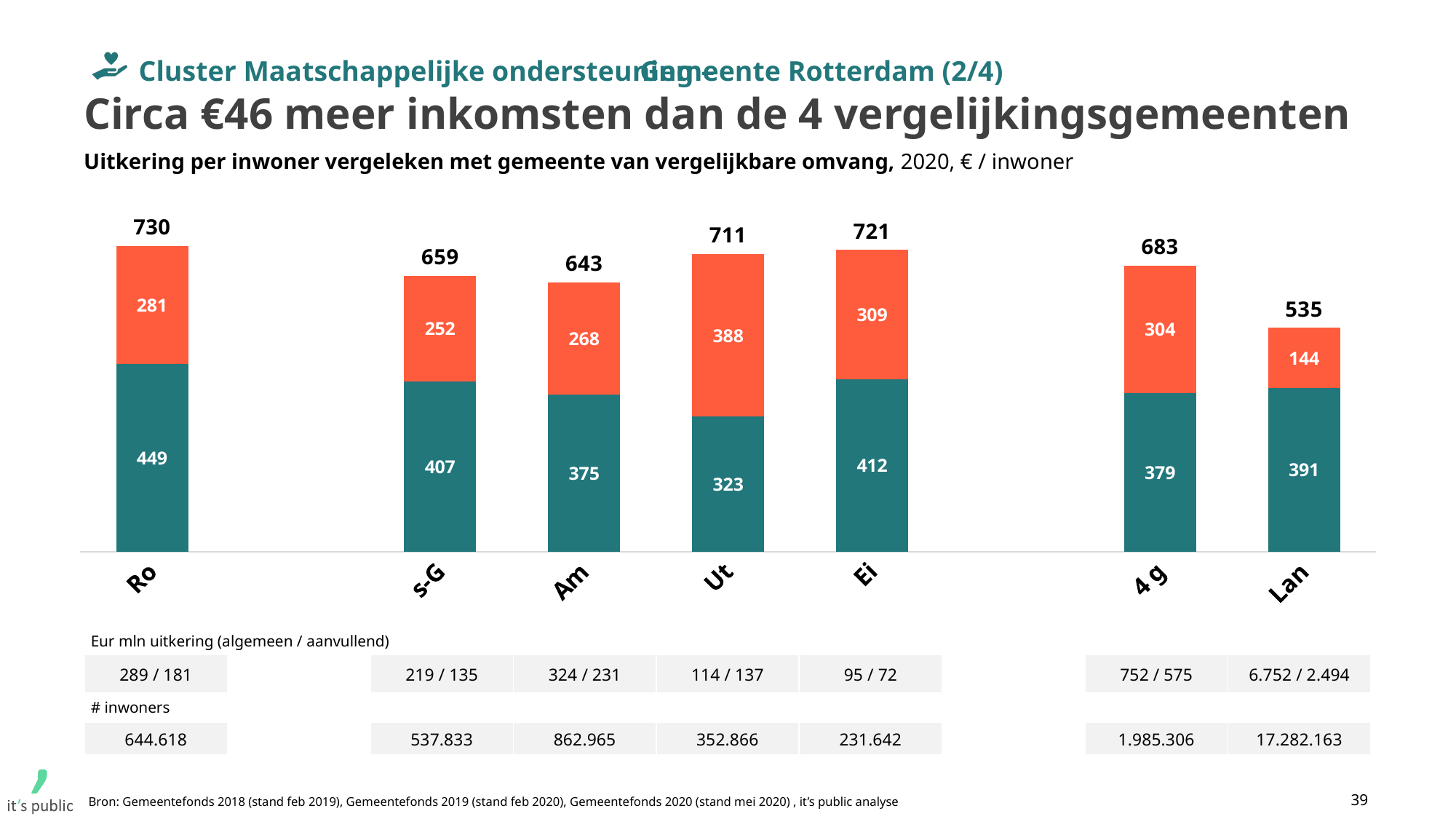
What is the sum of the two segments of the bar for s-G? 659 Which has a larger orange (top) segment, Ut or Am? Ut Which category has the highest total value? Ro What is the value of the orange (top) segment of the bar for Ei? 309 How many bars are shown in the chart? 7 What kind of chart is shown on the slide? Stacked bar chart What is the total value shown above the bar for Ro? 730 What is the value of the teal (bottom) segment of the bar for Ut? 323 Which category has the largest orange (top) segment? Ut Which category has the lowest total value? Lan What is the difference between the teal (bottom) segments of Ro and Lan? 58 What is the difference between the total for Ro and the total for 4 g? 47